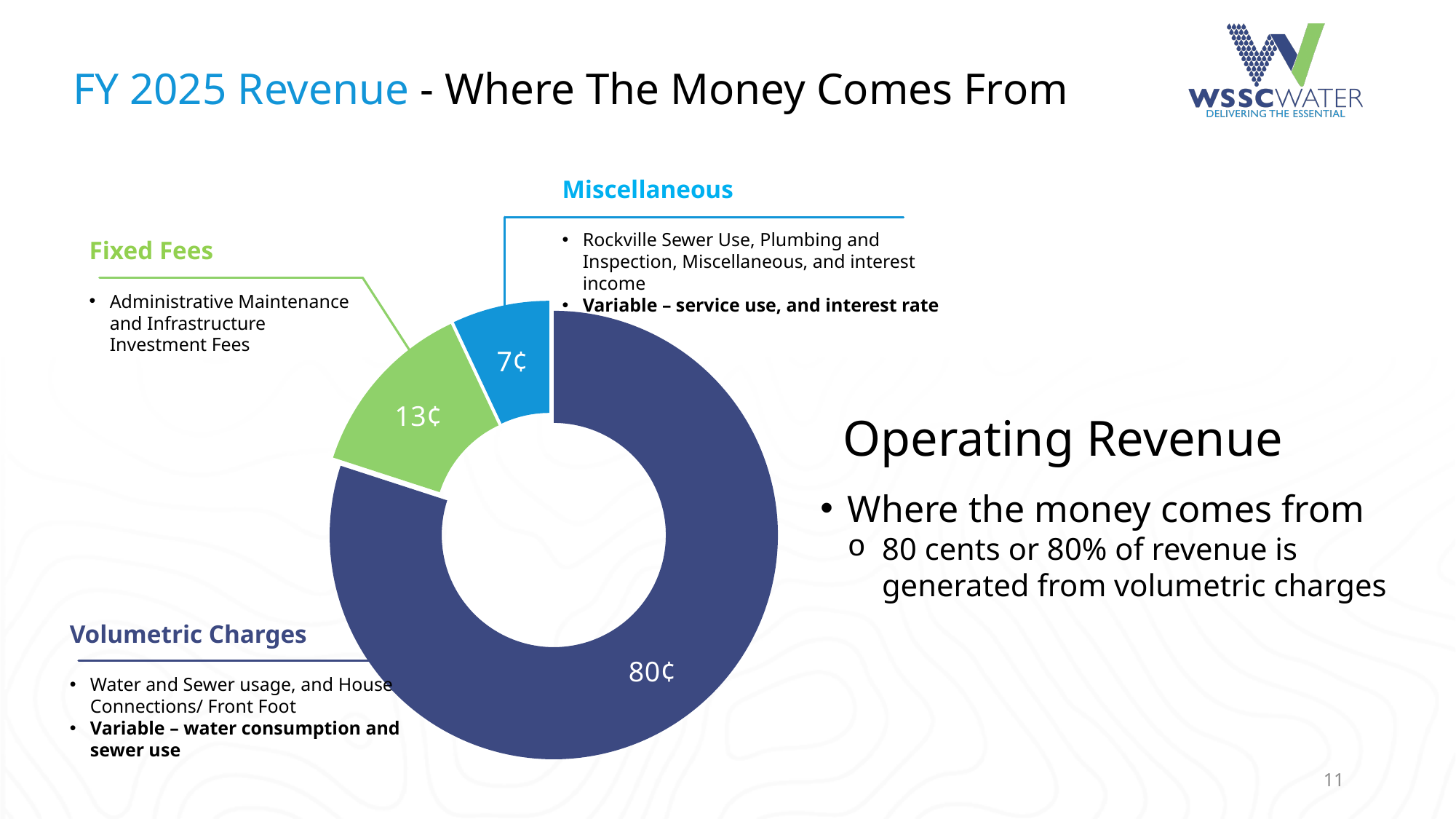
What is the difference between the Fixed Fees value and the Miscellaneous value? 6¢ Which category has the smallest slice in the donut chart? Miscellaneous How many categories are shown in the donut chart? 3 What kind of chart is shown on the slide? Donut (pie) chart Which is larger, the Fixed Fees slice or the Miscellaneous slice? Fixed Fees What value is shown for Fixed Fees in the donut chart? 13¢ What colour is the Fixed Fees slice in the donut chart? Green Which category has the largest slice in the donut chart? Volumetric Charges What value is shown for Volumetric Charges in the donut chart? 80¢ What value is shown for Miscellaneous in the donut chart? 7¢ What is the total of the three values shown in the donut chart? 100¢ What is the difference between the Volumetric Charges value and the Fixed Fees value? 67¢